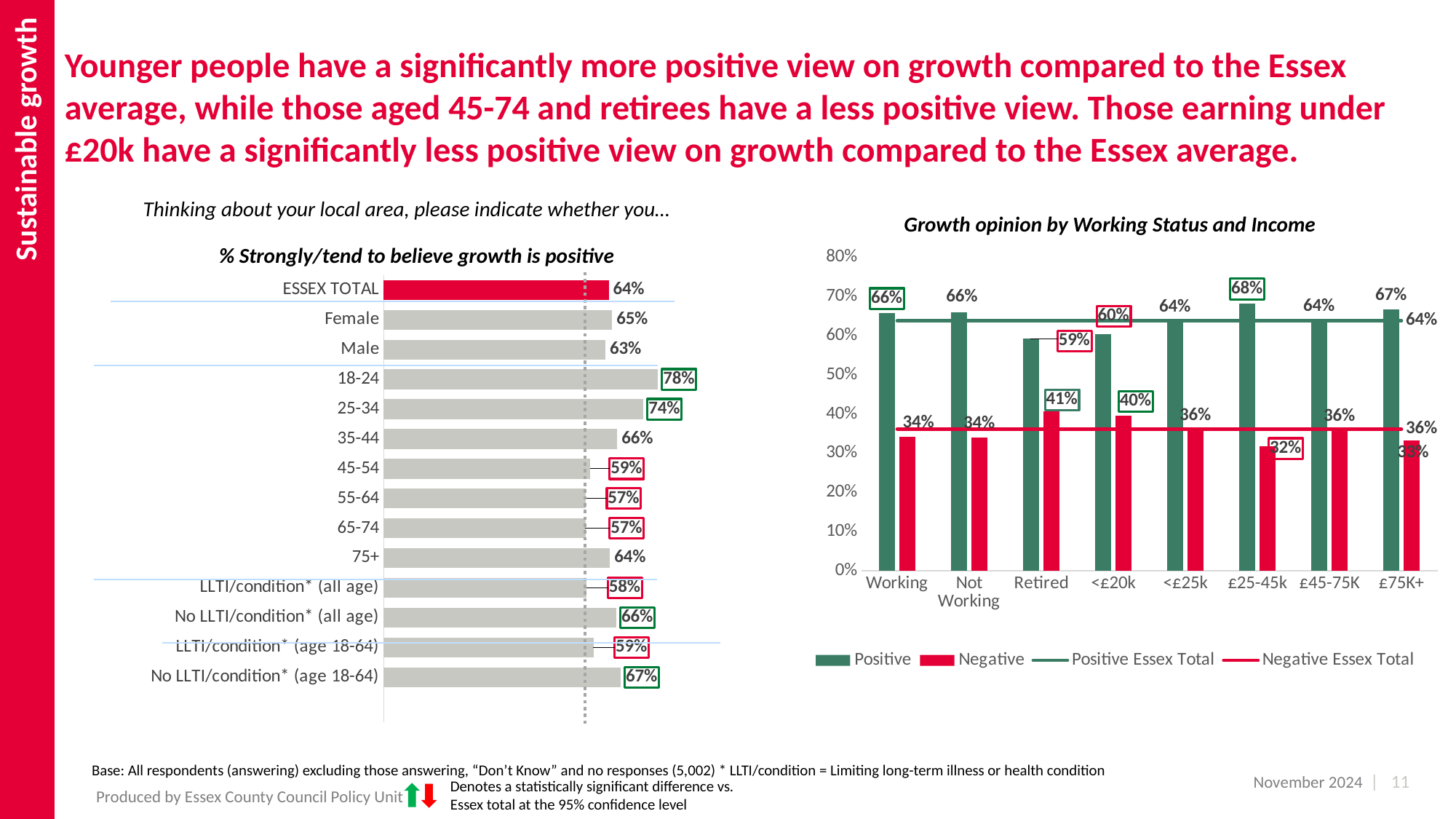
In the 'Growth opinion by Working Status and Income' chart, which category has the highest Positive value? £25-45k In the '% Strongly/tend to believe growth is positive' chart, what is the value for ESSEX TOTAL? 64% In the '% Strongly/tend to believe growth is positive' chart, which category has the highest value? 18-24 How many categories are shown in the '% Strongly/tend to believe growth is positive' chart? 14 In the 'Growth opinion by Working Status and Income' chart, what is the Negative value for <£20k? 40% In the 'Growth opinion by Working Status and Income' chart, what is the Positive value for Retired? 59% In the '% Strongly/tend to believe growth is positive' chart, what is the value for No LLTI/condition* (age 18-64)? 67% In the '% Strongly/tend to believe growth is positive' chart, which is larger, Female or Male? Female In the 'Growth opinion by Working Status and Income' chart, which category has the highest Negative value? Retired In the '% Strongly/tend to believe growth is positive' chart, what is the difference between the 18-24 and 25-34 values? 4% What kind of chart is the 'Growth opinion by Working Status and Income' chart? Combination bar and line chart How many entries does the legend of the 'Growth opinion by Working Status and Income' chart list? 4